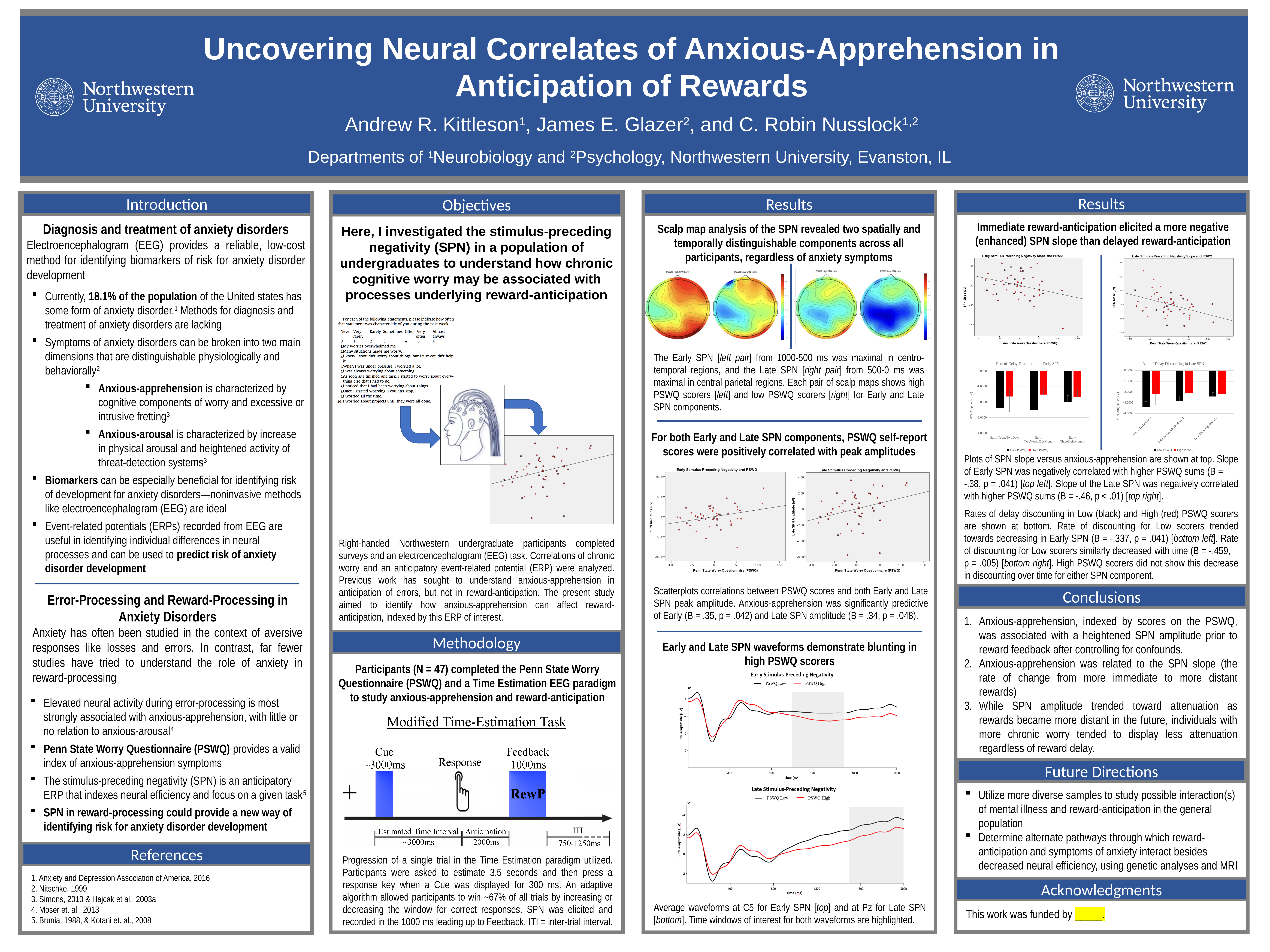
In the 'Early Stimulus-Preceding Negativity' waveform chart, what colour is the PSWQ High line? Red How many category groups of bars are shown in the 'Rate of Delay Discounting in Early SPN' chart? 3 In the 'Early Stimulus Preceding Negativity and PSWQ' scatter chart, what is the label on the x axis? Penn State Worry Questionnaire (PSWQ) How many series does the legend list in the 'Early Stimulus-Preceding Negativity' waveform chart? 2 In the 'Early Stimulus Preceding Negativity and PSWQ' chart in the third column, what kind of chart is shown? Scatter chart In the 'Late Stimulus-Preceding Negativity' waveform chart, what is the label on the x axis? Time (ms) In the 'Late Stimulus Preceding Negativity and PSWQ' scatter chart, does the fitted line rise or fall as PSWQ scores increase along the x axis? Rises In the 'Early Stimulus Preceding Negativity and PSWQ' scatter chart, does the fitted line rise or fall as PSWQ scores increase along the x axis? Rises What kind of chart is 'Rate of Delay Discounting in Early SPN' in the right-hand Results column? Bar chart In the 'Early Stimulus Preceding Negativity Slope and PSWQ' chart in the right-hand Results column, does the fitted line rise or fall along the x axis? Falls How many series does the legend list in the 'Rate of Delay Discounting in Late SPN' chart? 2 What are the two legend entries in the 'Late Stimulus-Preceding Negativity' waveform chart? PSWQ Low and PSWQ High